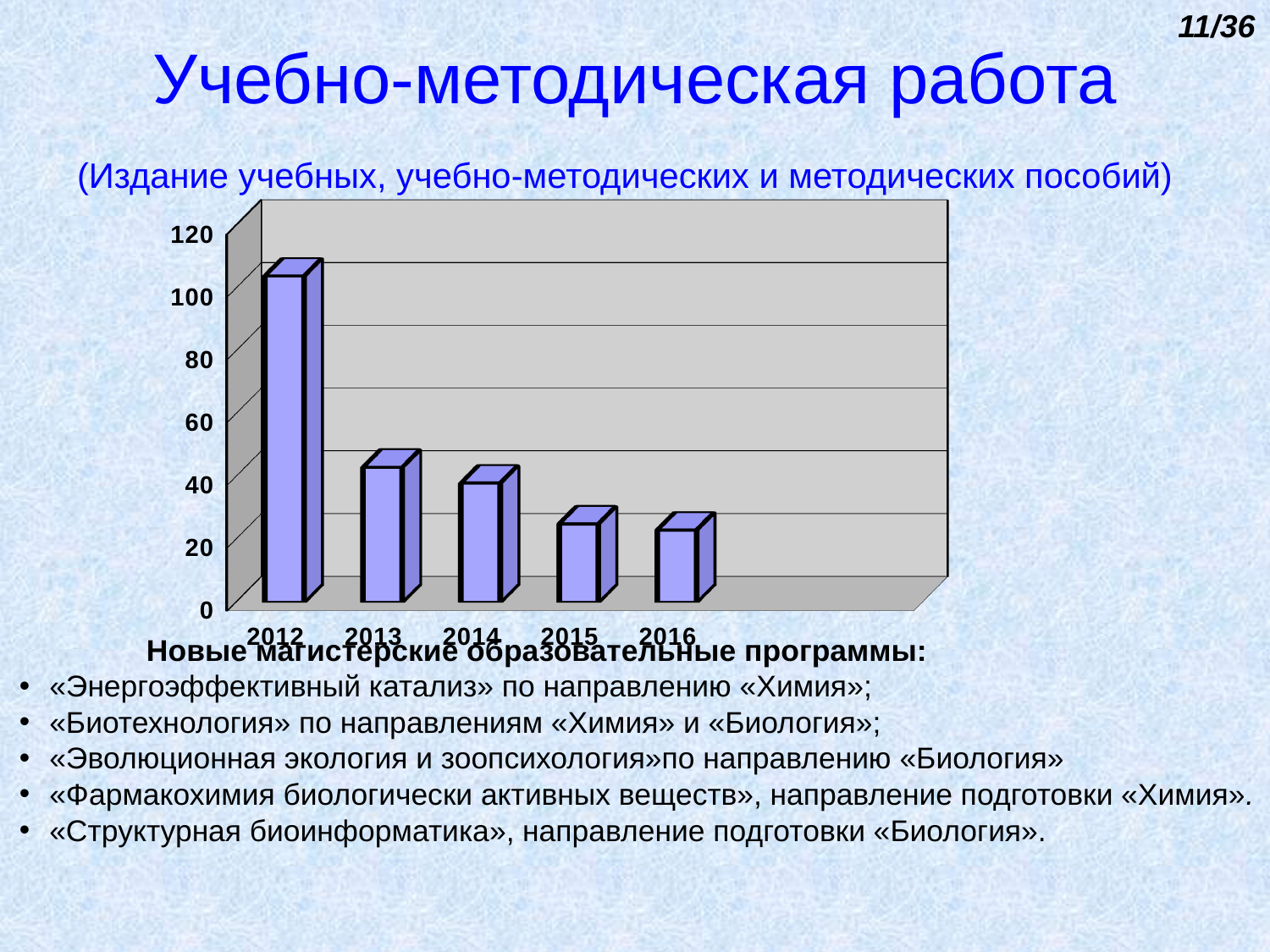
What is the highest tick value shown on the vertical axis of the chart? 120 Do the values rise or fall from 2012 to 2016? fall Which is larger, the value for 2012 or the value for 2013? 2012 Is the value for 2015 greater or less than 40? less Which year has the highest bar in the chart? 2012 Is the value for 2014 greater or less than 60? less Which is larger, the value for 2013 or the value for 2016? 2013 Is the value for 2016 greater or less than 40? less How many years are shown on the x axis of the chart? 5 What kind of chart is shown on the slide? bar chart